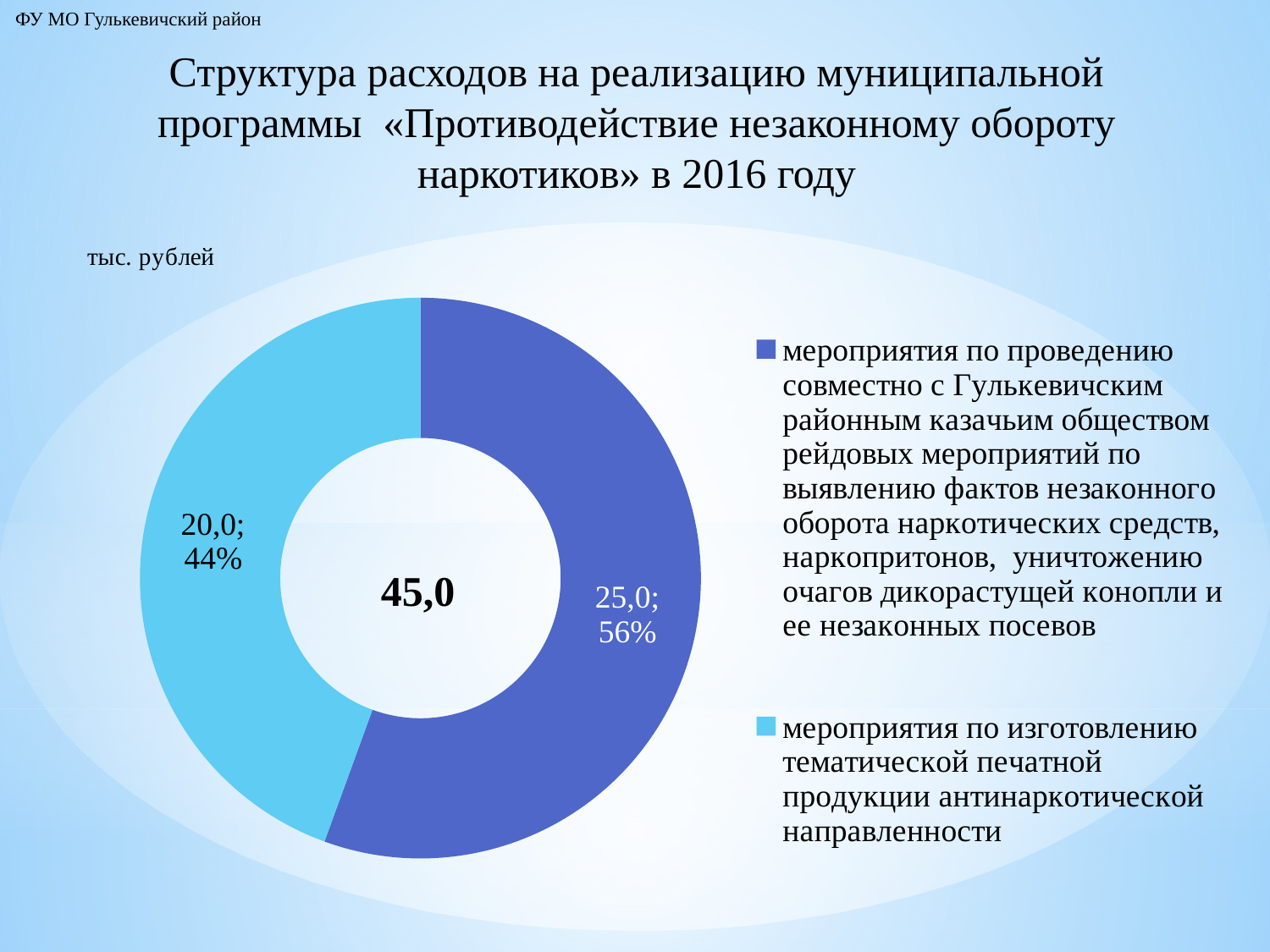
Which category has the largest slice? мероприятия по проведению совместно с Гулькевичским районным казачьим обществом рейдовых мероприятий Which category has the smallest slice? мероприятия по изготовлению тематической печатной продукции антинаркотической направленности What is the difference between the two slice values (25,0 and 20,0)? 5,0 What kind of chart is shown on the slide? doughnut (pie) chart How many categories does the chart show? 2 What is the value for «мероприятия по проведению совместно с Гулькевичским районным казачьим обществом рейдовых мероприятий...»? 25,0 What share of the chart does the slice for «мероприятия по изготовлению тематической печатной продукции» represent? 44% Which is larger: the slice for printed products (печатной продукции) or the slice for raid activities (рейдовых мероприятий)? рейдовых мероприятий What total value is shown in the centre of the doughnut? 45,0 In what units are the chart values given? тыс. рублей What share of the chart does the slice for the raid activities with the Гулькевичское районное казачье общество represent? 56% What is the value for «мероприятия по изготовлению тематической печатной продукции антинаркотической направленности»? 20,0